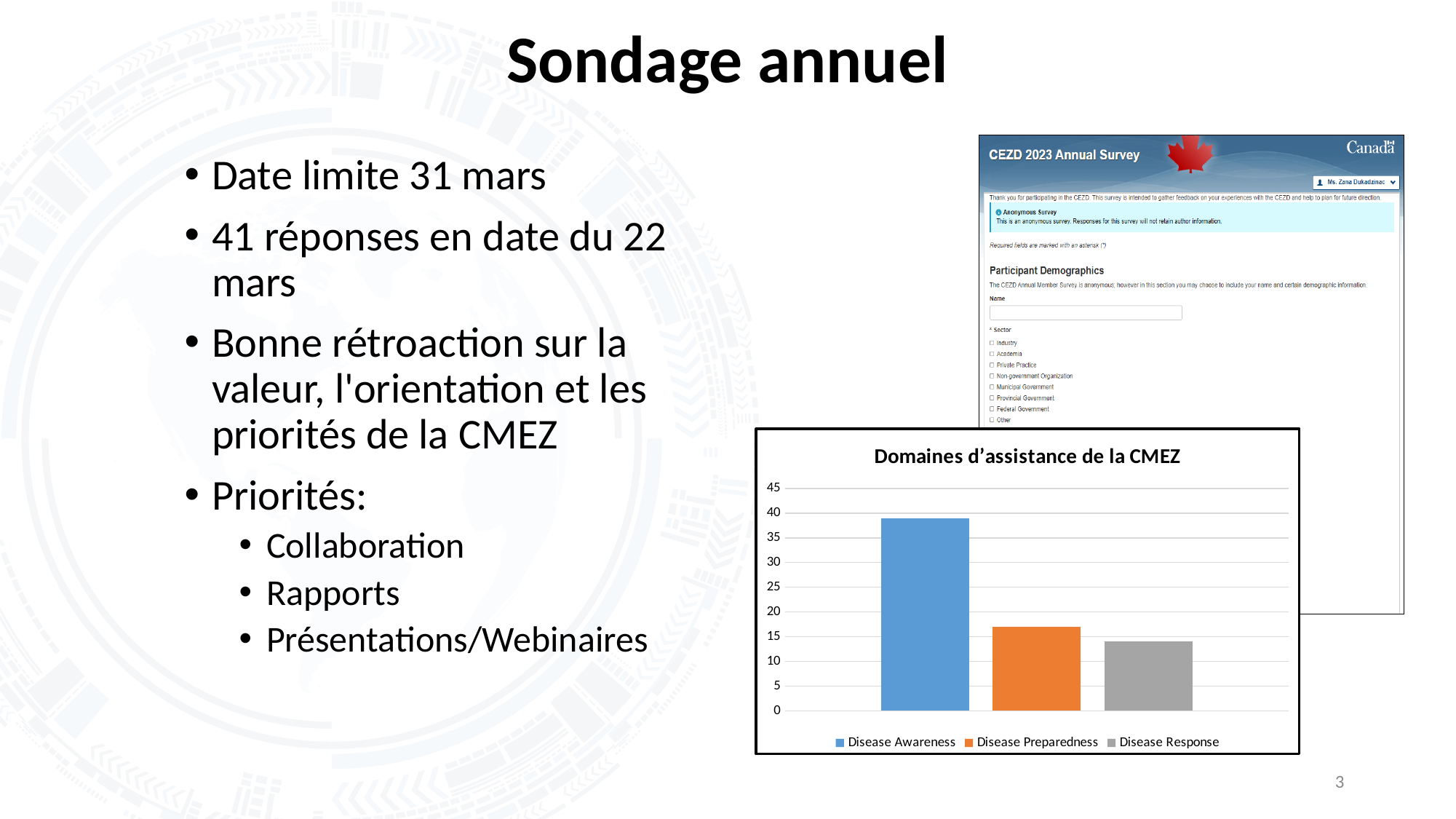
What colour is the Disease Awareness bar in the chart? blue How many series does the chart legend list? 3 Which series has the lowest value in the chart? Disease Response How many bars are plotted in the chart? 3 Which is larger, the value for Disease Preparedness or the value for Disease Response? Disease Preparedness Is the value for Disease Response greater or less than 10? greater Is the value for Disease Awareness greater or less than 35? greater Is the value for Disease Preparedness greater or less than 20? less Which series has the highest value in the chart? Disease Awareness What kind of chart is shown on the slide? bar chart What is the title of the chart on the slide? Domaines d’assistance de la CMEZ